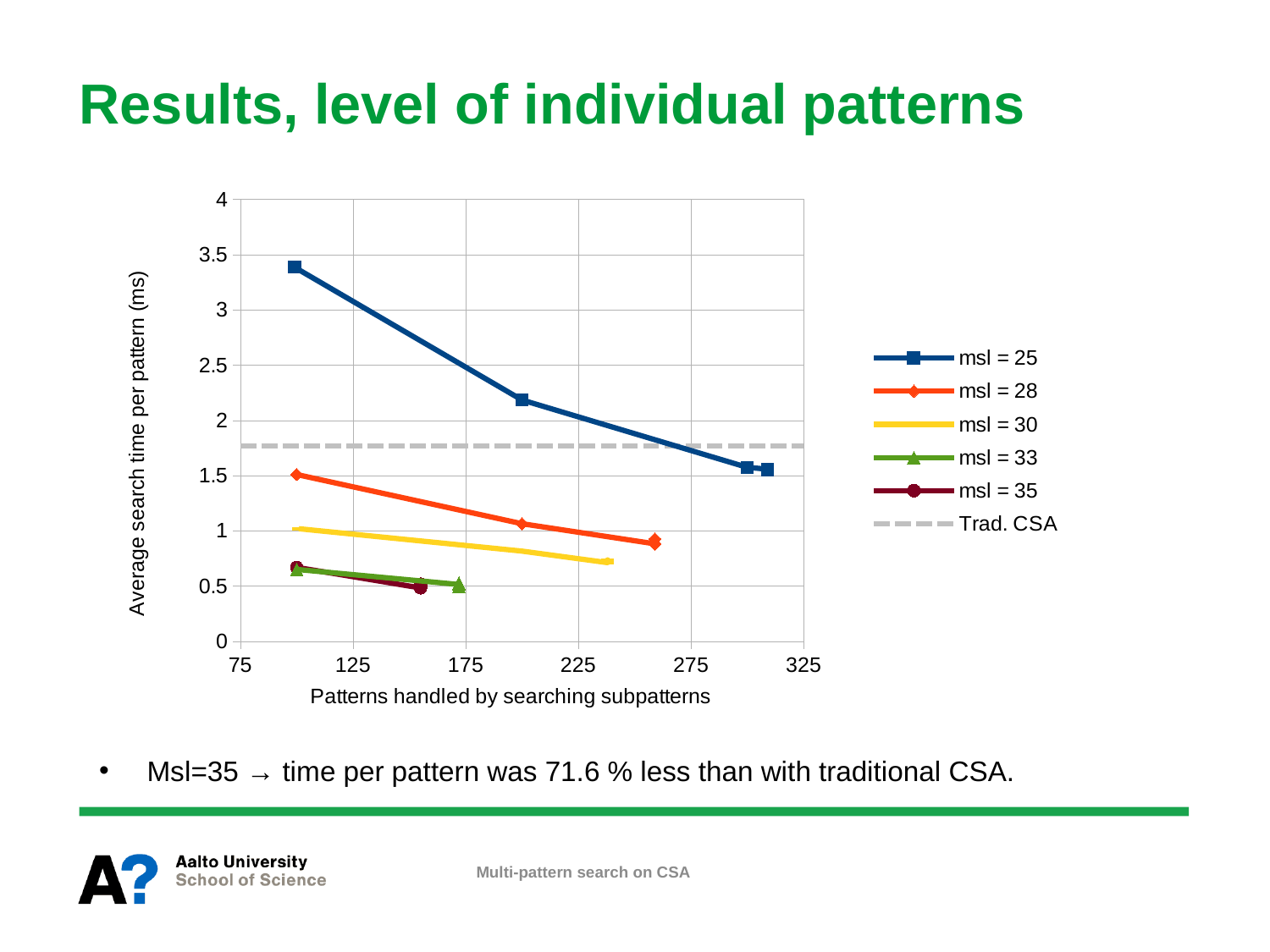
How many series does the legend list? 6 Does the average search time for msl = 25 rise or fall as the number of patterns handled by searching subpatterns increases? fall Which series has higher average search times, msl = 25 or msl = 35? msl = 25 Is the value of the Trad. CSA line greater or less than 1.5? greater What kind of chart is shown on the slide? line chart Is the value of the Trad. CSA line greater or less than 2? less Which series is drawn as a grey dashed line? Trad. CSA Is the first value for msl = 25 (at 100 patterns) greater or less than 3? greater Which series has the highest average search time per pattern? msl = 25 What is the label of the y axis? Average search time per pattern (ms)